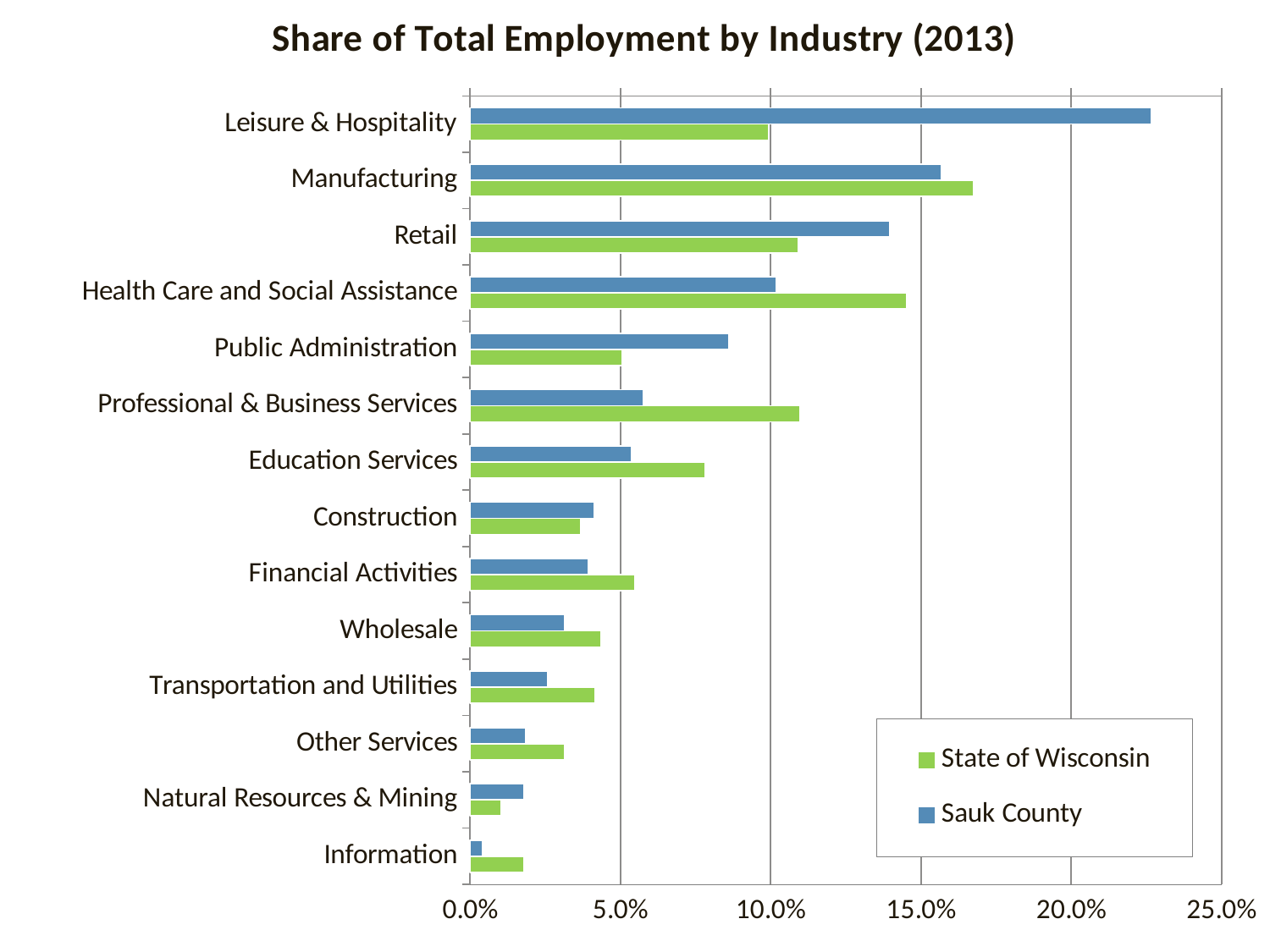
What type of chart is shown on the slide? bar chart Is the Sauk County value for Leisure & Hospitality greater or less than 20.0%? greater Which industry has the highest share of total employment for the State of Wisconsin? Manufacturing For Health Care and Social Assistance, which is larger: the State of Wisconsin share or the Sauk County share? State of Wisconsin Is the State of Wisconsin value for Education Services greater or less than 5.0%? greater How many industries are listed on the chart? 14 Which industry has the lowest share of total employment for the State of Wisconsin? Natural Resources & Mining Which industry has the lowest share of total employment for Sauk County? Information Which industry has the highest share of total employment for Sauk County? Leisure & Hospitality How many series does the legend list? 2 Is the Sauk County value for Public Administration greater or less than 10.0%? less What is the title of the chart? Share of Total Employment by Industry (2013)